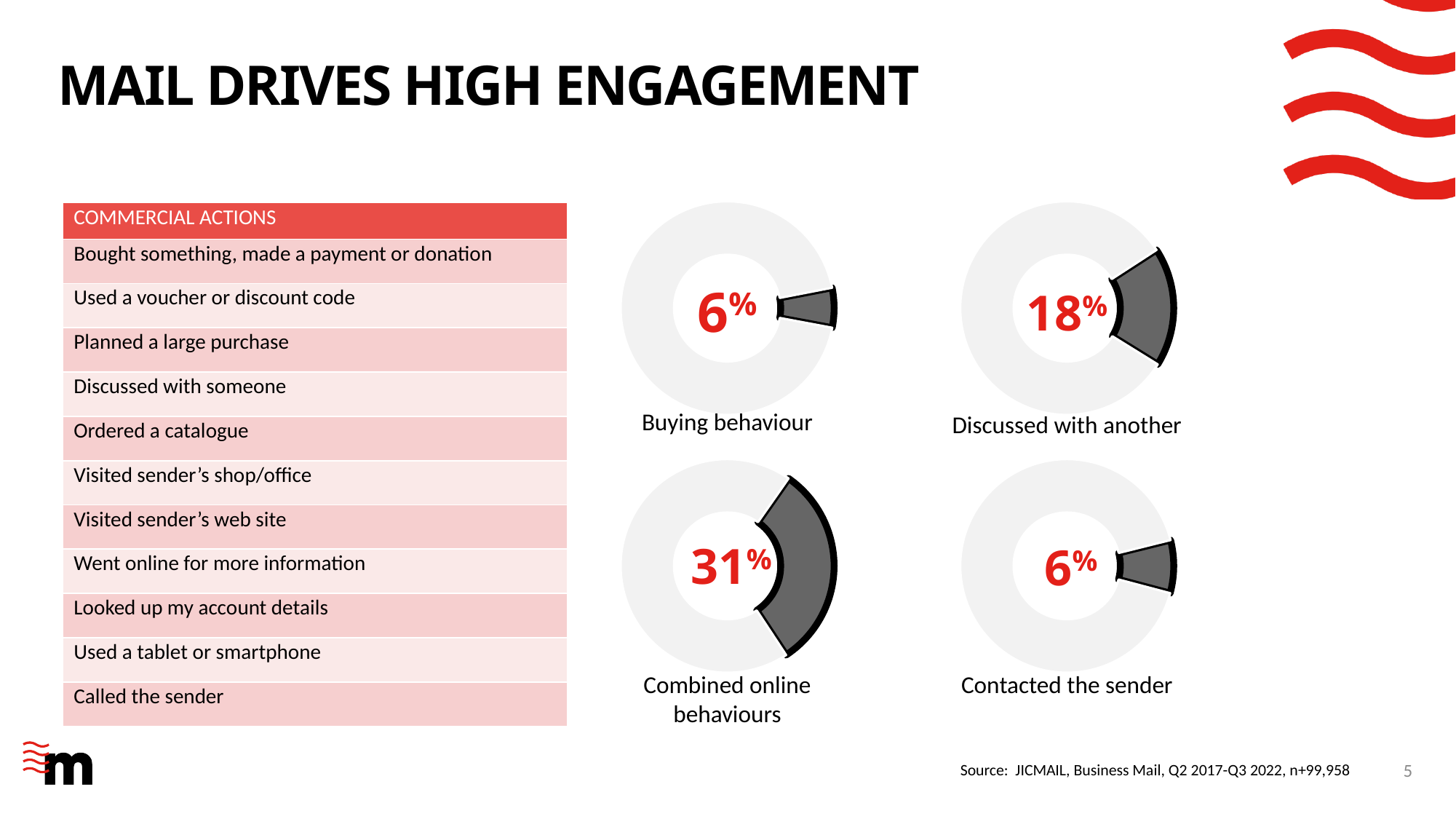
Which of the four donut charts shows the highest value? Combined online behaviours What is the difference between the values in the "Combined online behaviours" and "Discussed with another" donut charts? 13% What is the difference between the values in the "Discussed with another" and "Buying behaviour" donut charts? 12% What is the title of the slide containing the donut charts? MAIL DRIVES HIGH ENGAGEMENT Which two donut charts show the same value? Buying behaviour and Contacted the sender Which is larger, the value in the "Discussed with another" chart or the value in the "Contacted the sender" chart? Discussed with another What value is shown in the "Discussed with another" donut chart? 18% What value is shown in the "Buying behaviour" donut chart? 6% What value is shown in the "Combined online behaviours" donut chart? 31% How many donut charts are shown on the slide? 4 What kind of chart is used to show the "Buying behaviour" value? Donut chart What value is shown in the "Contacted the sender" donut chart? 6%